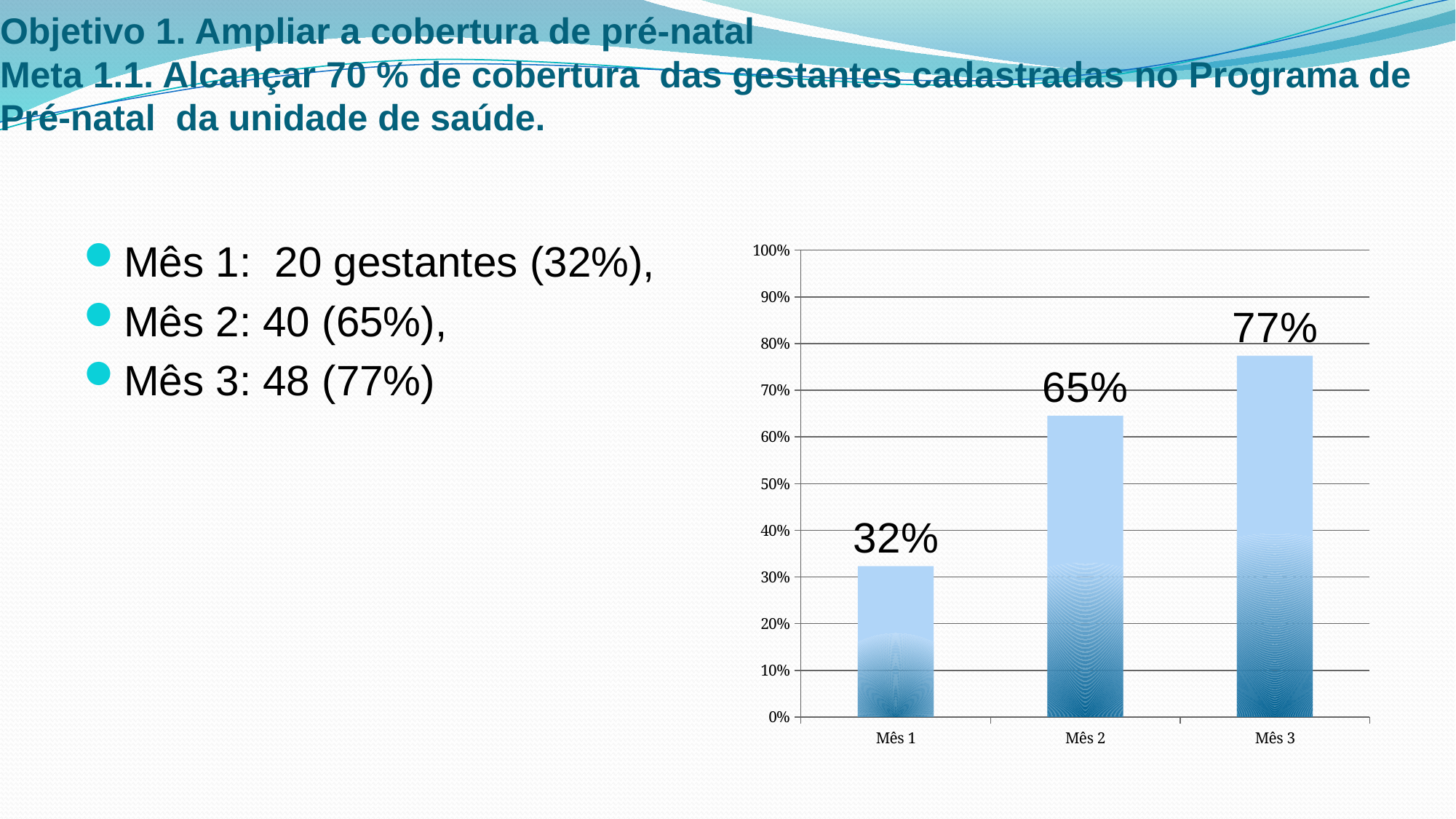
Is the value for Mês 2 greater or less than 70%? less What kind of chart is shown on the slide? bar chart Which is larger, the value for Mês 2 or the value for Mês 3? Mês 3 What is the difference between the values for Mês 3 and Mês 1? 45% Which category has the lowest value? Mês 1 How many categories are shown on the x axis? 3 What is the value for Mês 3? 77% Do the values rise or fall from Mês 1 to Mês 3? rise What is the value for Mês 1? 32% What is the difference between the values for Mês 2 and Mês 1? 33% Which category has the highest value? Mês 3 What is the value for Mês 2? 65%